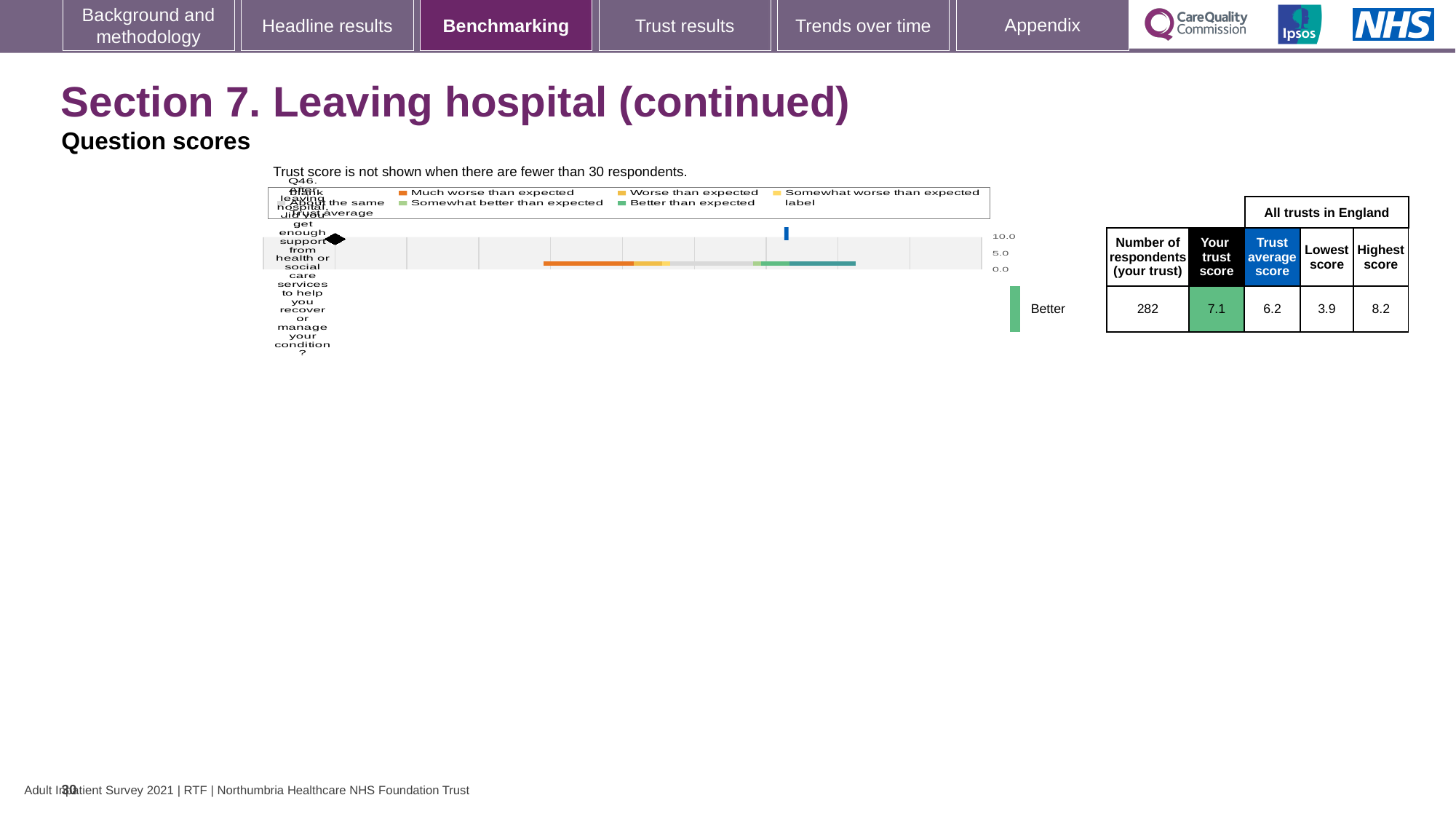
Which is larger for Q46: the trust score or the trust average score? Trust score What is the difference between the trust score and the trust average score for Q46? 0.9 What is the difference between the highest and lowest scores across all trusts in England for Q46? 4.3 How many questions are plotted on the benchmarking chart? 1 What is the trust score for Q46 shown on the slide? 7.1 What is the highest score among all trusts in England for Q46? 8.2 What kind of chart is used to show the Q46 benchmarking result? Bar chart Is the trust score for Q46 greater or less than 5.0 on the chart axis? greater What benchmark category label is shown next to the chart for Q46? Better What is the lowest score among all trusts in England for Q46? 3.9 How many respondents from the trust answered Q46? 282 What is the trust average score for Q46 across all trusts in England? 6.2